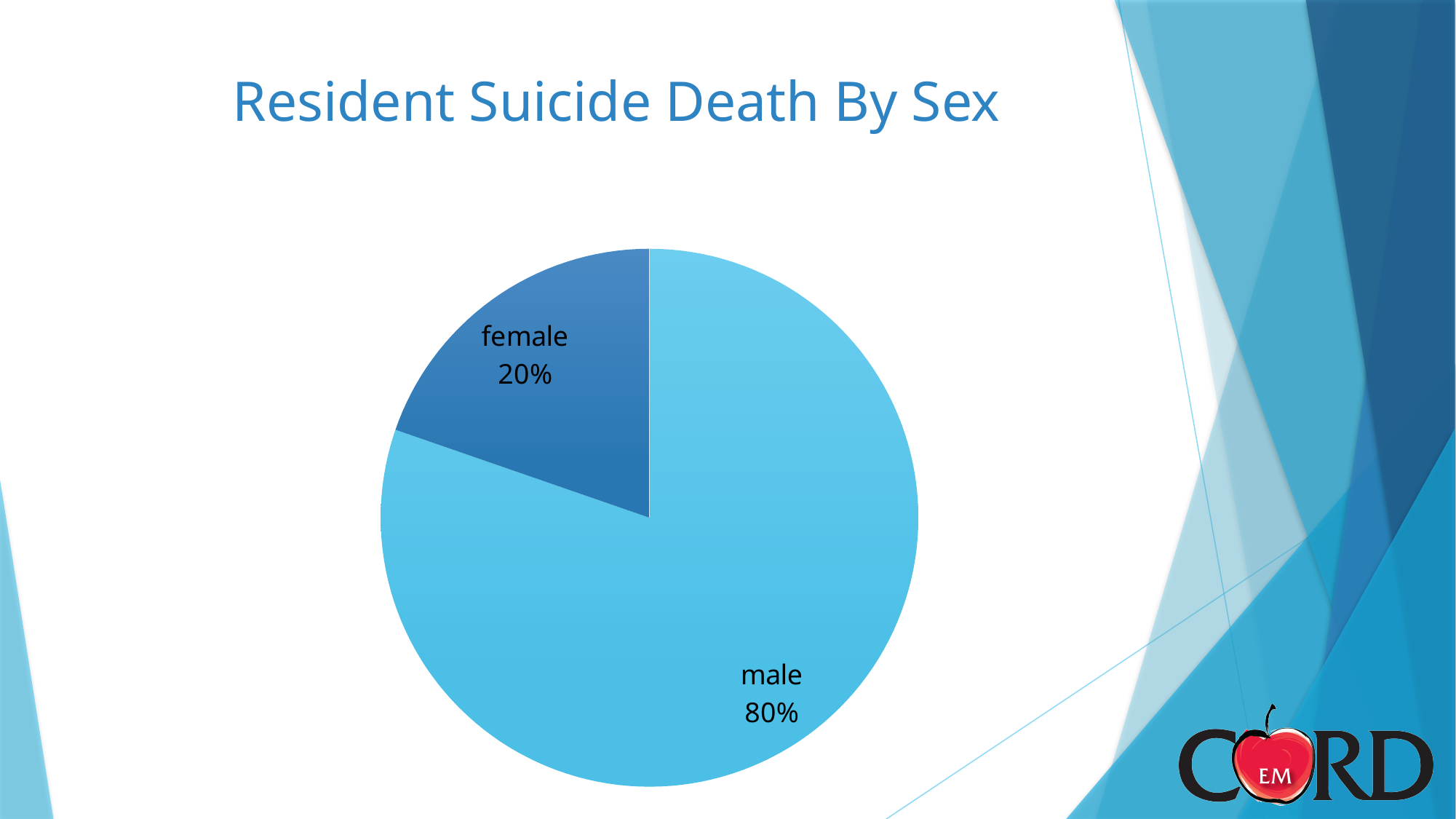
Which is larger, the male share or the female share? male What is the total of the two percentages shown in the pie chart? 100% What is the title of the chart on the slide? Resident Suicide Death By Sex What is the difference in percentage points between the male and female shares? 60 How many categories are shown in the pie chart? 2 Which category has the largest slice of the pie? male Which category has the smallest slice of the pie? female What share of resident suicide deaths is male? 80% What kind of chart is shown on the slide? pie chart What share of resident suicide deaths is female? 20% Which slice is shown in the darker blue colour? female